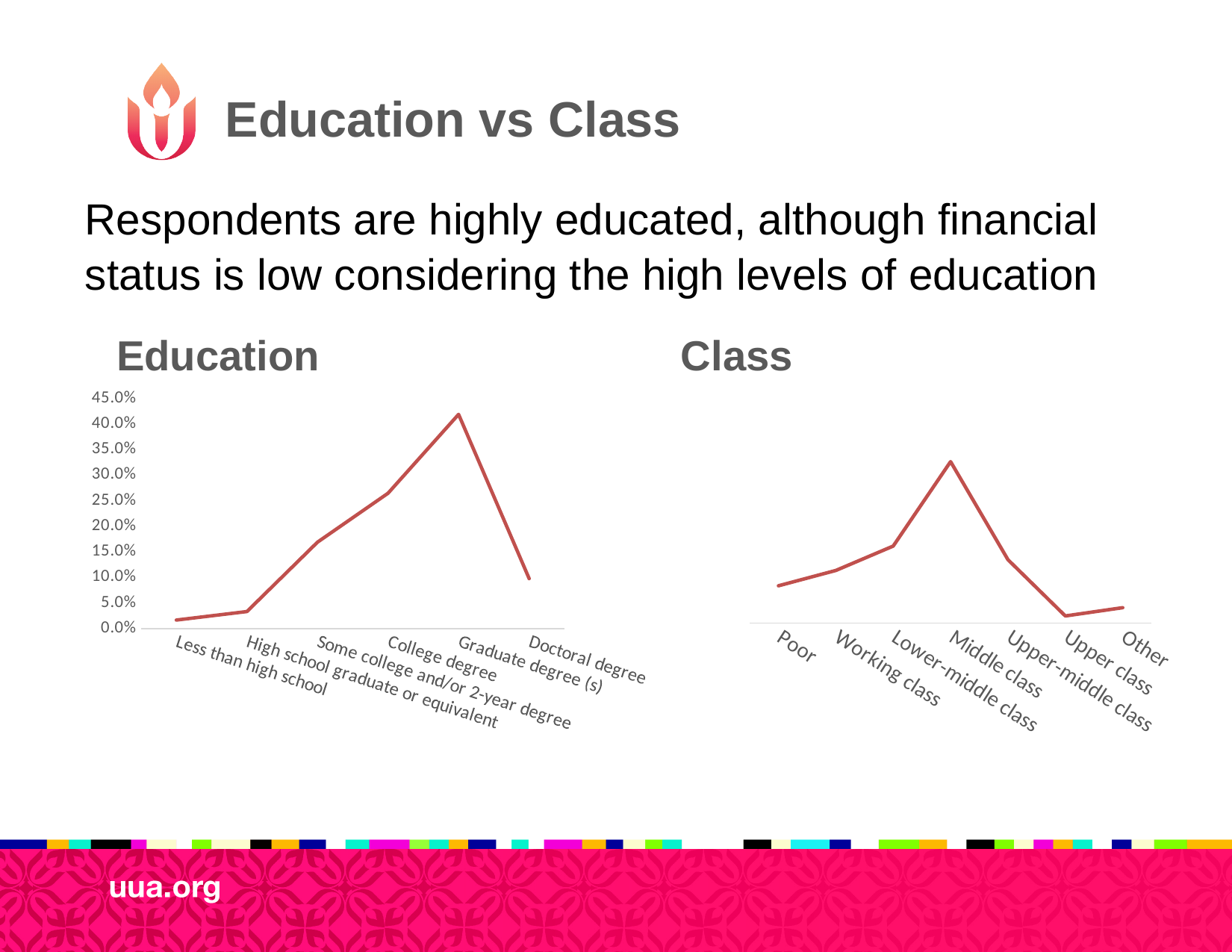
On the Class chart, which category has the highest value? Middle class How many categories are plotted on the Education chart? 6 On the Education chart, which category has the lowest value? Less than high school On the Education chart, is the value for High school graduate or equivalent greater or less than 5.0%? less On the Education chart, which is larger, the value for College degree or the value for Doctoral degree? College degree On the Education chart, is the value for College degree greater or less than 25.0%? greater What kind of chart is the Class chart? Line chart How many categories are plotted on the Class chart? 7 On the Education chart, is the value for Graduate degree (s) greater or less than 40.0%? greater On the Class chart, which category has the lowest value? Upper class On the Education chart, which category has the highest value? Graduate degree (s)